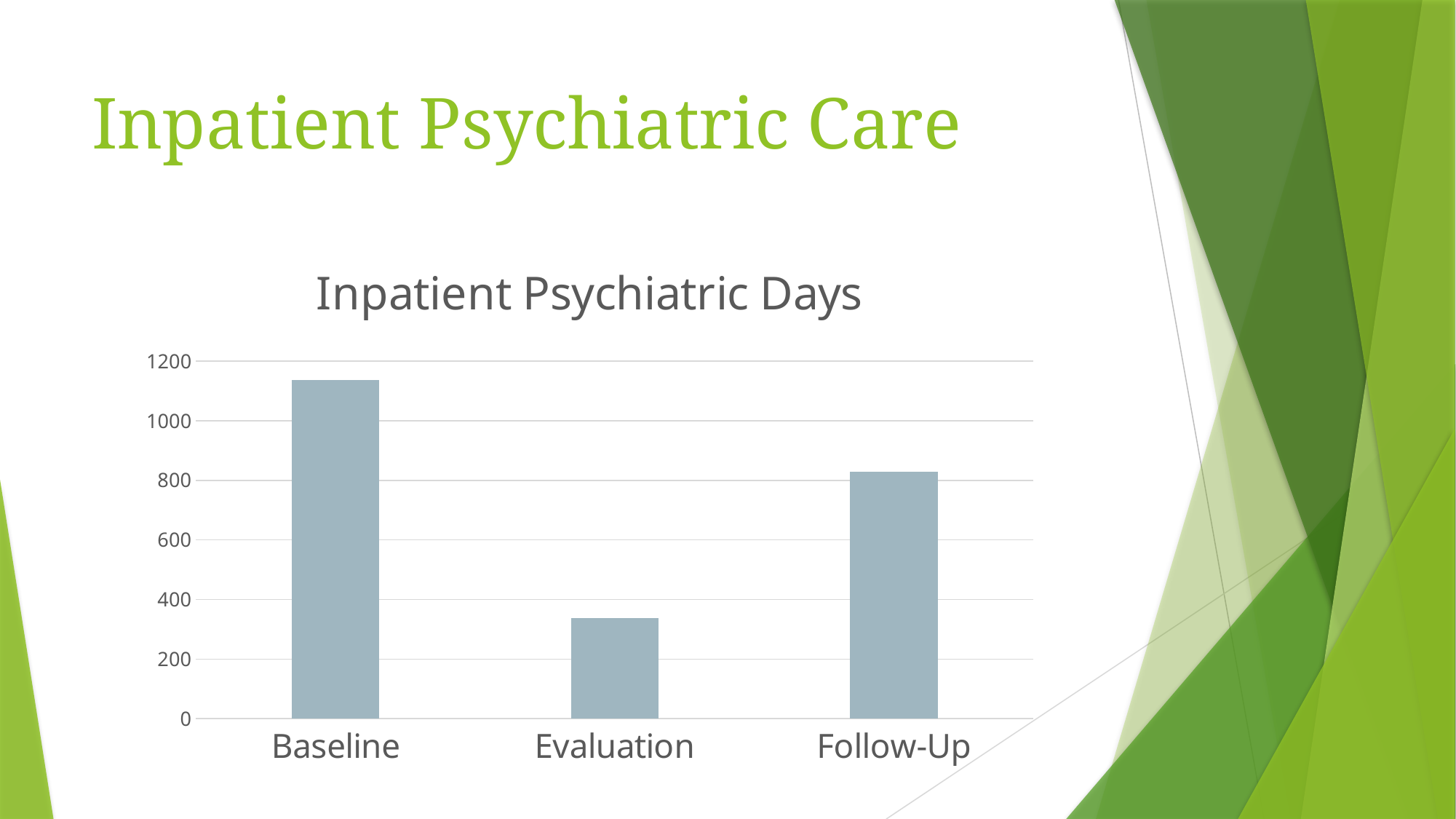
What type of chart is shown on the slide? bar chart Is the value for Follow-Up greater or less than 800? greater Which is larger, the value for Follow-Up or the value for Evaluation? Follow-Up Which category has the highest value? Baseline Which is larger, the value for Baseline or the value for Follow-Up? Baseline Is the value for Baseline greater or less than 1200? less Which category has the lowest value? Evaluation Is the value for Baseline greater or less than 1000? greater What is the highest value labelled on the vertical axis? 1200 How many categories are shown on the x axis of the chart? 3 What is the title of the chart? Inpatient Psychiatric Days